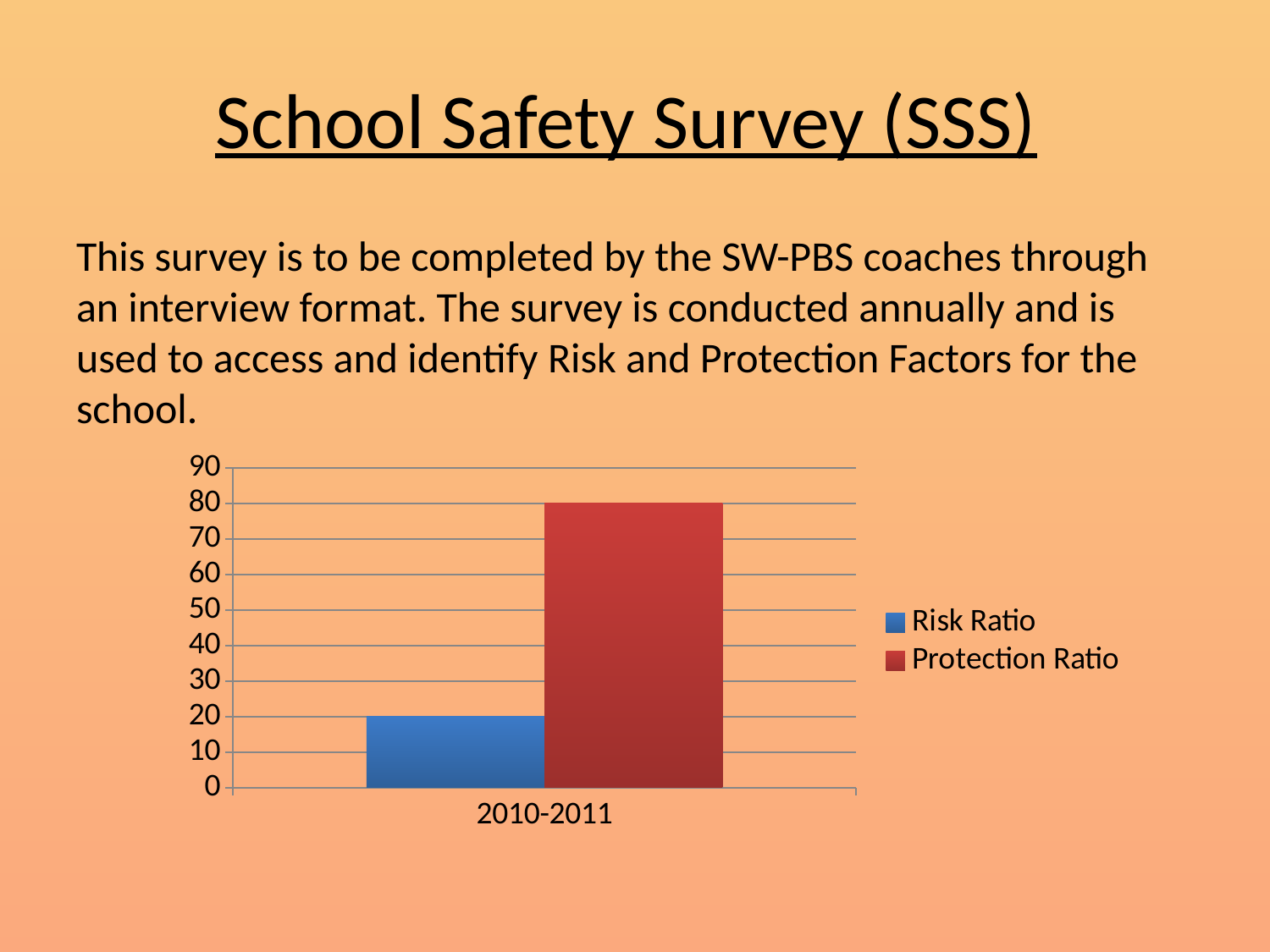
How many categories are shown on the x axis? 1 What colour is the Protection Ratio series in the legend? Red Which series has the higher bar for 2010-2011, Risk Ratio or Protection Ratio? Protection Ratio Which series has the highest bar on the chart? Protection Ratio Is the Risk Ratio value greater or less than 30? less What is the difference between the Protection Ratio and the Risk Ratio for 2010-2011? 60 Which series has the lowest bar on the chart? Risk Ratio What is the value of the Risk Ratio bar for 2010-2011? 20 What is the value of the Protection Ratio bar for 2010-2011? 80 Is the Protection Ratio value greater or less than 50? greater How many series does the legend list? 2 What kind of chart is shown on the slide? Bar chart